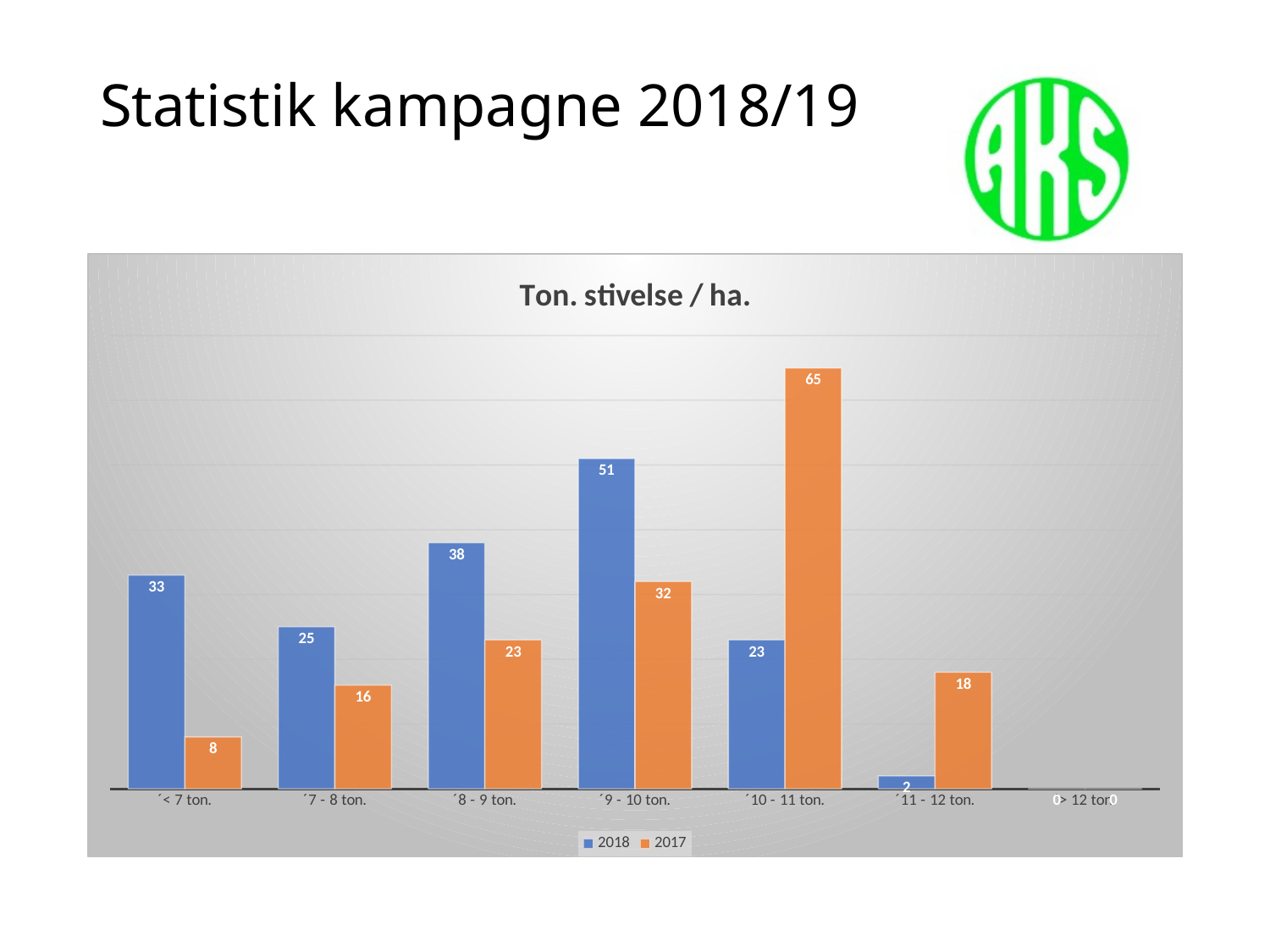
What is the 2017 value for the '10 - 11 ton.' category? 65 Which category has the lowest 2017 value? > 12 ton. What is the 2017 value for the '< 7 ton.' category? 8 How many series does the legend list? 2 What is the difference between the 2017 and 2018 values for the '10 - 11 ton.' category? 42 What is the 2018 value for the '9 - 10 ton.' category? 51 Which category has the highest 2018 value? 9 - 10 ton. What kind of chart is shown on the slide? Bar chart For the '8 - 9 ton.' category, which series has the larger value, 2018 or 2017? 2018 How many categories are shown on the x axis? 7 Which category has the highest 2017 value? 10 - 11 ton. What is the title of the chart? Ton. stivelse / ha.